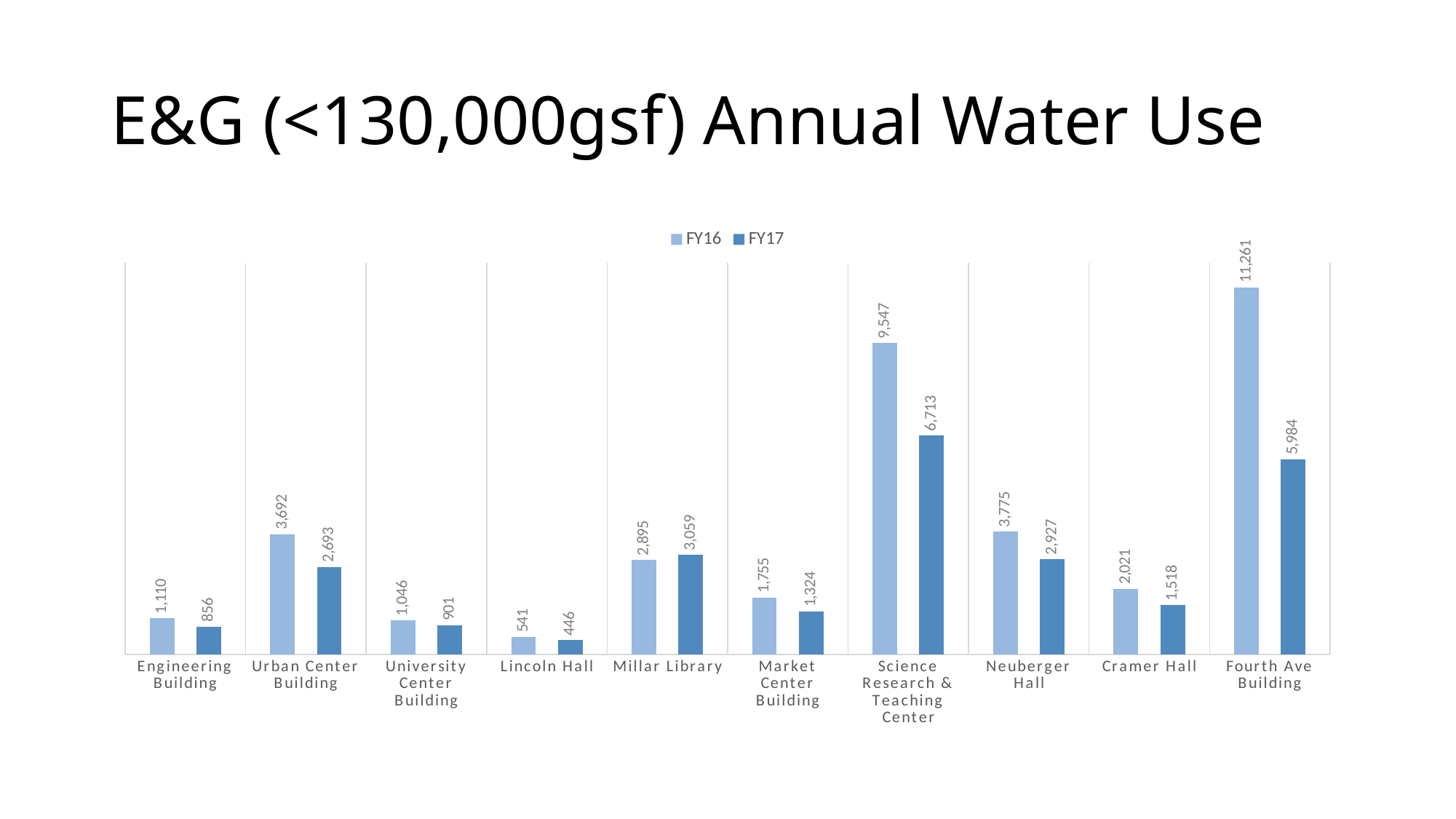
Which is larger, the FY17 value for Neuberger Hall or the FY17 value for Urban Center Building? Neuberger Hall What is the difference between the FY16 and FY17 values for Fourth Ave Building? 5,277 How many buildings are shown on the x axis? 10 How many series does the legend list? 2 What is the difference between the FY16 and FY17 values for Urban Center Building? 999 Which building has the highest FY16 value? Fourth Ave Building What is the FY17 value for Millar Library? 3,059 What is the FY17 value for Lincoln Hall? 446 Which building has the lowest FY17 value? Lincoln Hall Which is larger for Millar Library, the FY16 value or the FY17 value? FY17 What kind of chart is shown on the slide? Bar chart What is the FY16 value for Science Research & Teaching Center? 9,547